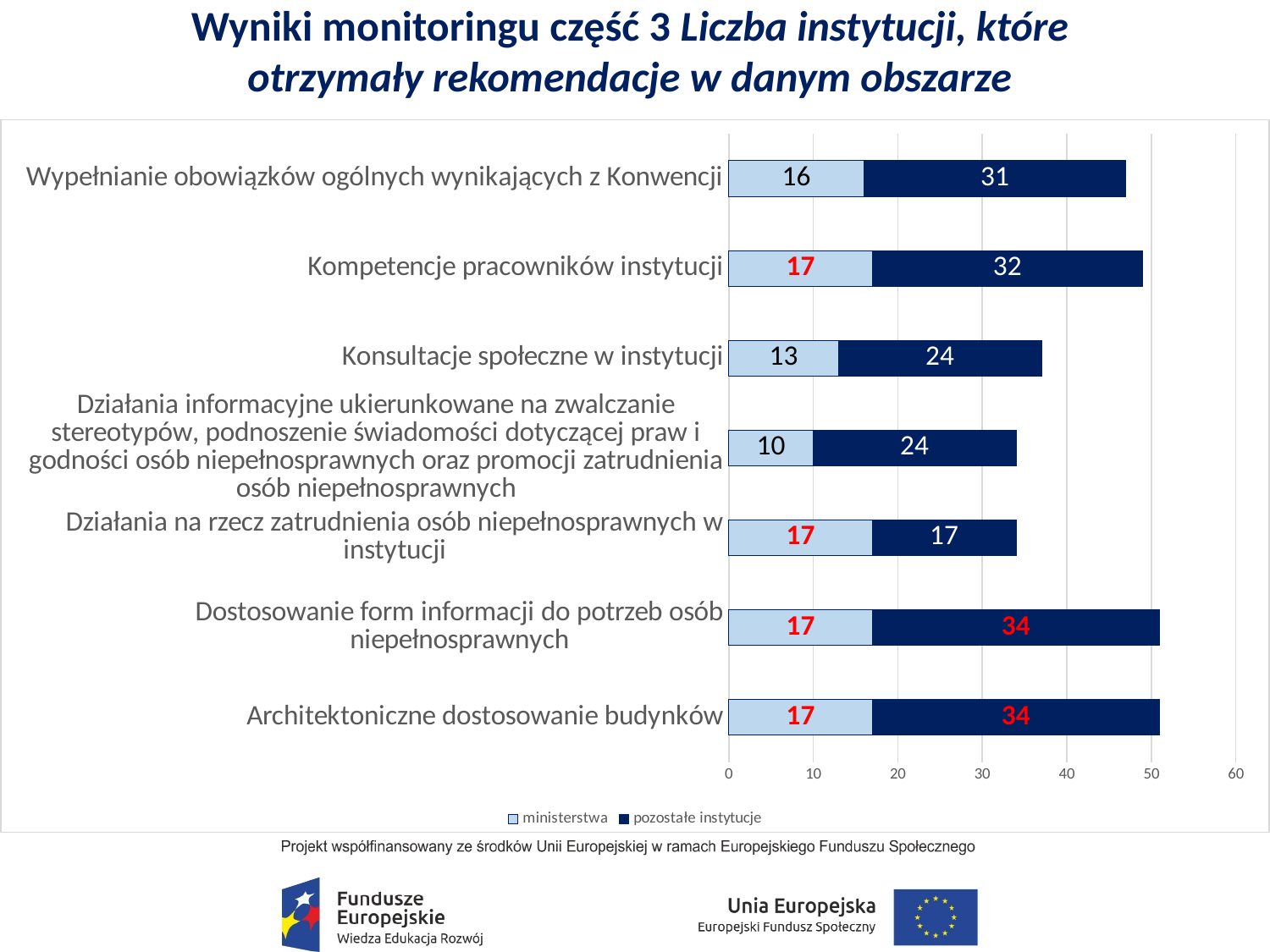
How many categories are shown on the chart? 7 Which category has the lowest value for 'pozostałe instytucje'? Działania na rzecz zatrudnienia osób niepełnosprawnych w instytucji What is the value for 'ministerstwa' in the category 'Konsultacje społeczne w instytucji'? 13 Which category has the lowest value for 'ministerstwa'? Działania informacyjne ukierunkowane na zwalczanie stereotypów, podnoszenie świadomości dotyczącej praw i godności osób niepełnosprawnych oraz promocji zatrudnienia osób niepełnosprawnych What is the total of the stacked bar for 'Konsultacje społeczne w instytucji'? 37 What is the difference between the 'pozostałe instytucje' values for 'Dostosowanie form informacji do potrzeb osób niepełnosprawnych' and 'Konsultacje społeczne w instytucji'? 10 What is the value for 'pozostałe instytucje' in the category 'Kompetencje pracowników instytucji'? 32 How many series does the legend list? 2 What is the value for 'ministerstwa' in the category 'Wypełnianie obowiązków ogólnych wynikających z Konwencji'? 16 What is the total of the stacked bar for 'Architektoniczne dostosowanie budynków'? 51 What kind of chart is shown on the slide? Stacked bar chart Which is larger: the 'pozostałe instytucje' value for 'Kompetencje pracowników instytucji' or for 'Wypełnianie obowiązków ogólnych wynikających z Konwencji'? Kompetencje pracowników instytucji